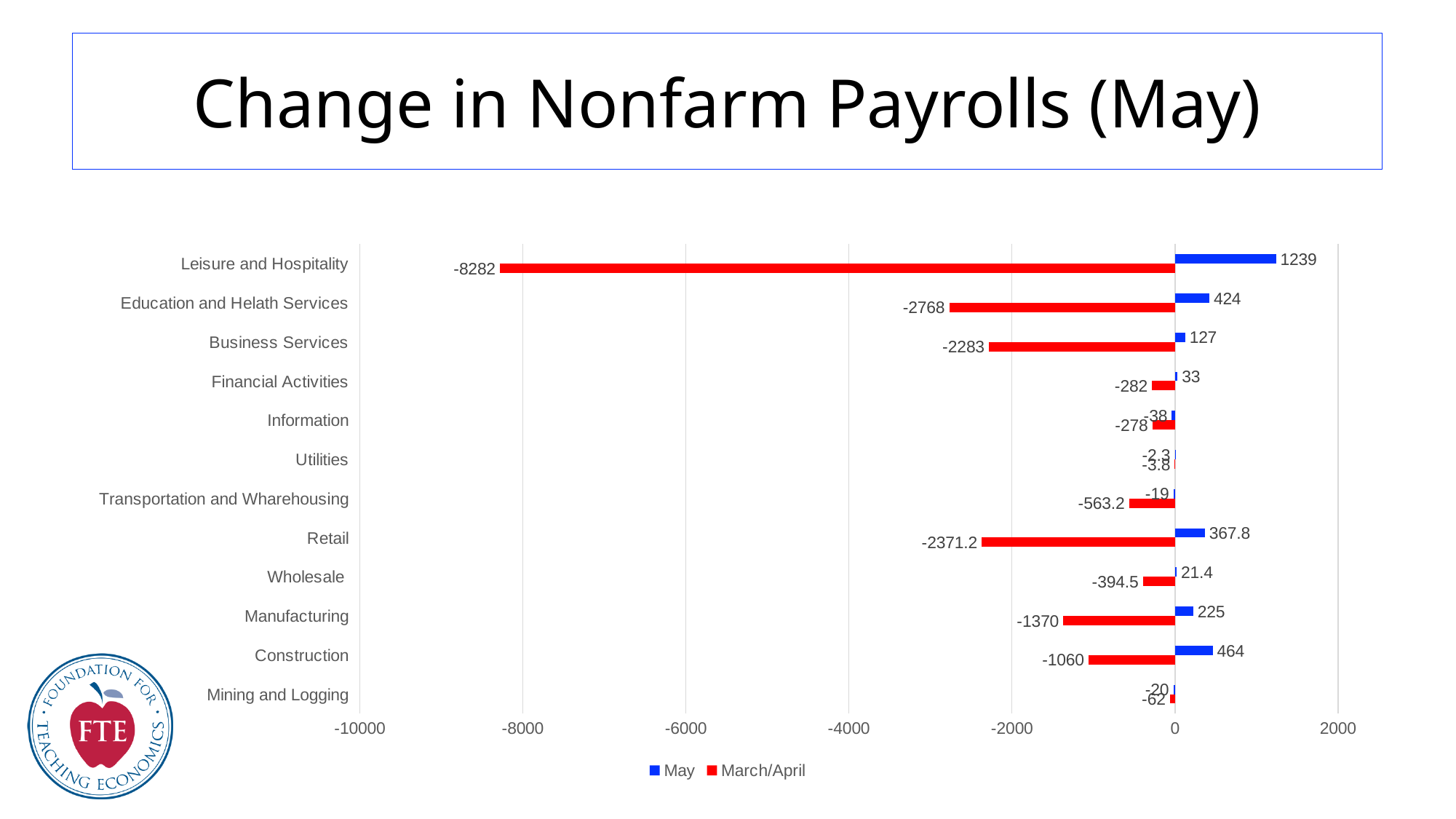
Which is larger, the March/April value for Construction or for Manufacturing? Construction What is the difference between the May values for Construction and Education and Helath Services? 40 Which category has the lowest March/April value? Leisure and Hospitality What is the March/April value for Retail? -2371.2 How many series does the legend list? 2 What is the May value for Leisure and Hospitality? 1239 What is the March/April value for Manufacturing? -1370 What kind of chart is shown on the slide? Bar chart Which colour represents the March/April series? Red What is the May value for Construction? 464 How many categories are shown on the chart? 12 Which category has the highest May value? Leisure and Hospitality